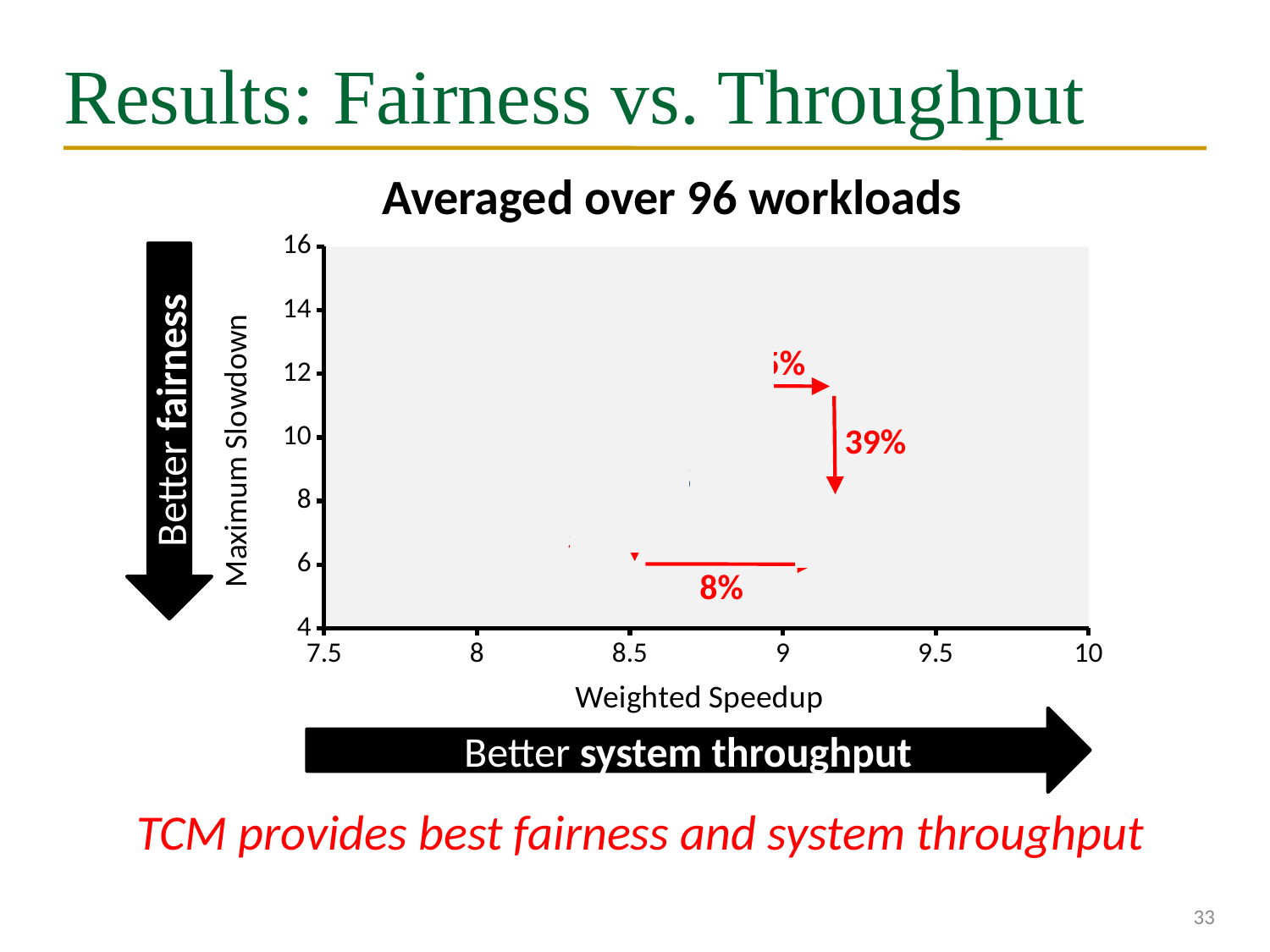
What percentage is printed next to the downward red arrow in the chart? 39% What is the label of the x axis of the chart? Weighted Speedup What percentage is printed below the horizontal red arrow near the bottom of the chart? 8% What kind of chart is shown on the slide? scatter chart What is the title of the chart? Averaged over 96 workloads What is the lowest value shown on the x axis (Weighted Speedup) of the chart? 7.5 What is the highest value shown on the y axis (Maximum Slowdown) of the chart? 16